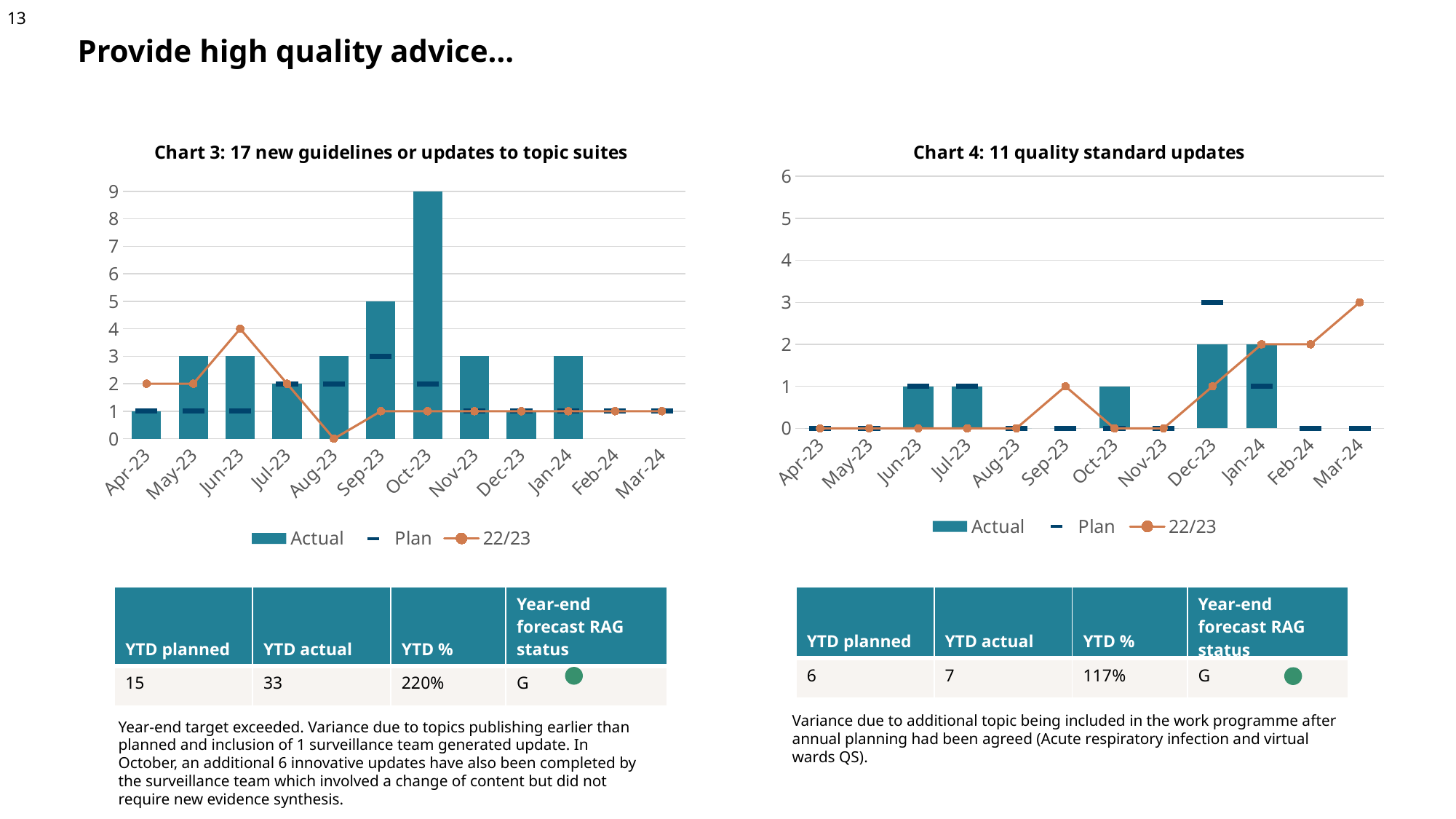
In Chart 3, which month has the highest Actual bar? Oct-23 In Chart 3, is the Actual value for Oct-23 greater or less than 5? greater In Chart 3, which is larger, the Actual value for Jul-23 or the Actual value for Aug-23? Aug-23 How many series does the legend of Chart 4 list? 3 In Chart 3, what is the 22/23 value for Jun-23? 4 How many months are shown on the x axis of Chart 4? 12 In Chart 4, does the 22/23 line rise or fall from Nov-23 to Mar-24? rise In Chart 4, which month has the highest 22/23 value? Mar-24 In Chart 3, what is the Actual value for Oct-23? 9 In Chart 4, what is the Plan value for Dec-23? 3 In Chart 3, what is the Actual value for Sep-23? 5 In Chart 3, what is the difference between the Actual value for Oct-23 and the Actual value for Sep-23? 4